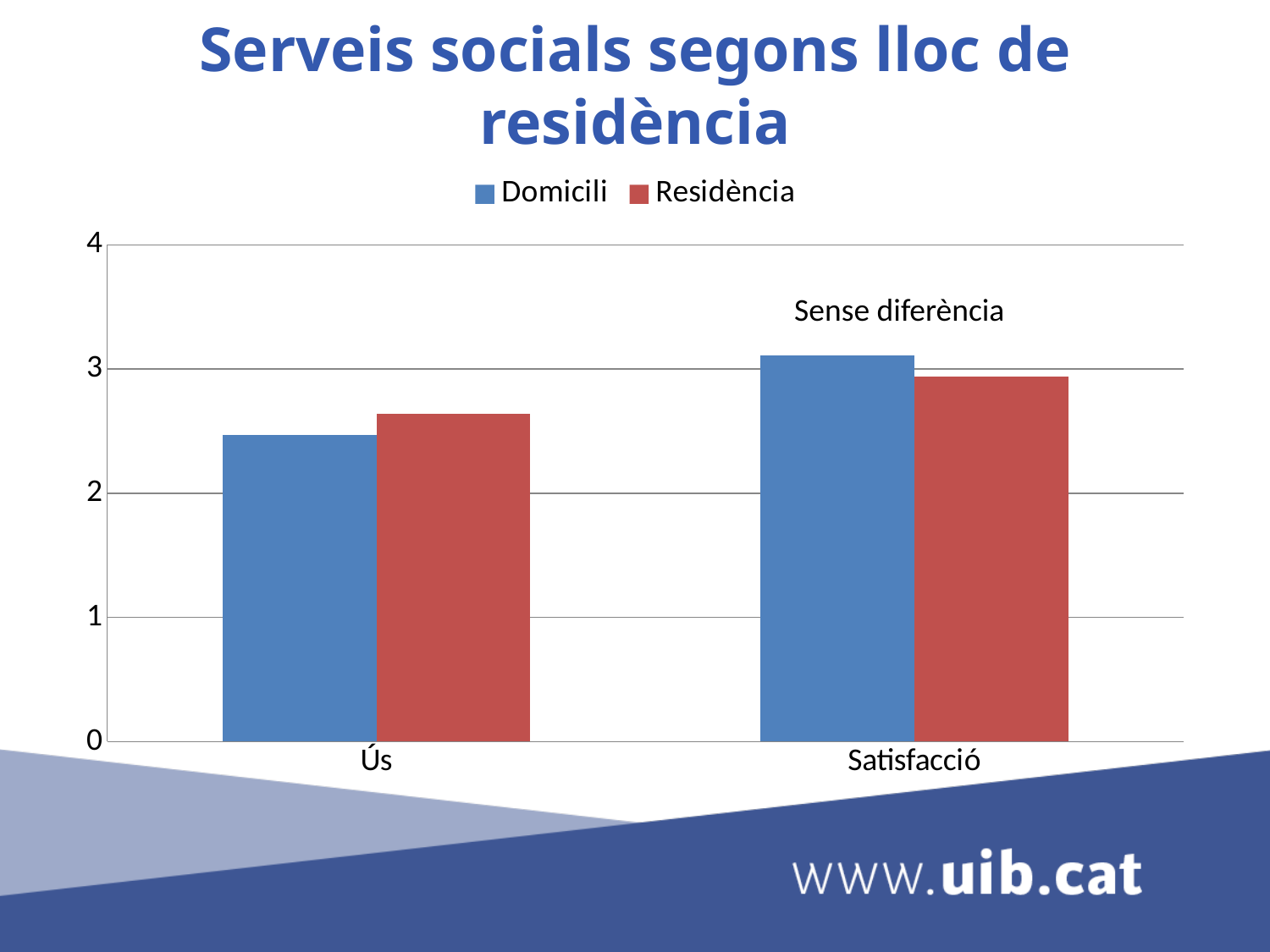
Is the Domicili value for Ús greater or less than 2? greater What kind of chart is shown on the slide? bar chart Is the Residència value for Ús greater or less than 3? less Is the Domicili value for Ús greater or less than 3? less Which bar is the tallest in the chart? Domicili for Satisfacció How many series does the legend list? 2 For the Ús category, which series has the larger value, Domicili or Residència? Residència What is the title of the chart? Serveis socials segons lloc de residència Does the Domicili series rise or fall from Ús to Satisfacció? rise How many categories are shown on the x axis? 2 Which series are listed in the legend? Domicili and Residència